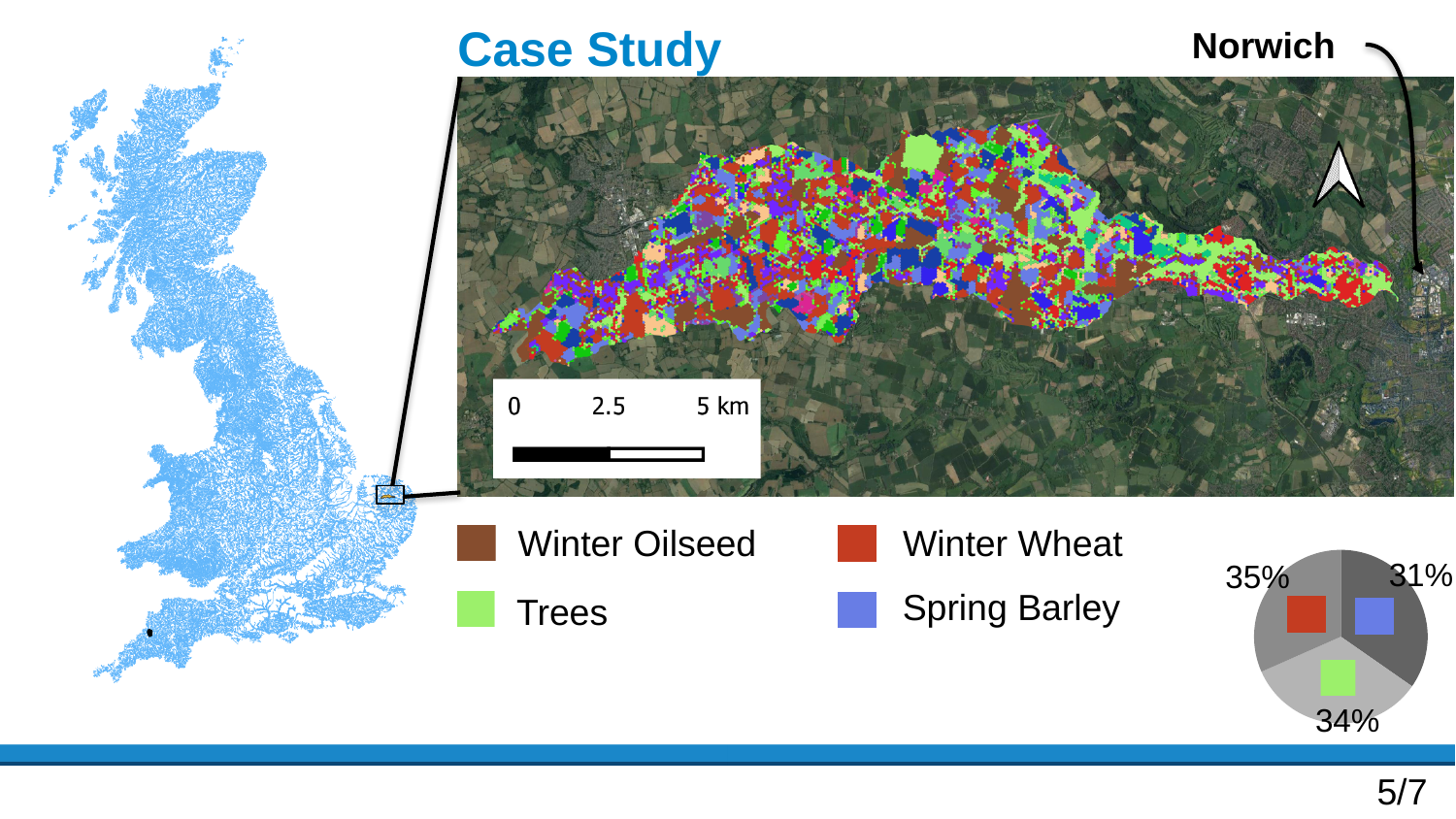
In the pie chart, what percentage is shown for the slice marked with the red square (Winter Wheat)? 35% What do the three percentages in the pie chart add up to? 100% In the pie chart, which is larger: the Trees slice or the Spring Barley slice? Trees Which slice of the pie chart has the smallest share? Spring Barley (31%) In the pie chart, what percentage is shown for the slice marked with the green square (Trees)? 34% How many land-cover classes are listed in the map legend below the case study image? 4 How many slices does the pie chart in the bottom-right corner have? 3 Which legend class from the map is not represented as a slice in the pie chart? Winter Oilseed Which slice of the pie chart has the largest share? Winter Wheat (35%) What kind of chart is shown in the bottom-right corner of the slide? pie chart In the pie chart, what is the difference between the largest slice (35%) and the smallest slice (31%)? 4 percentage points In the pie chart, what percentage is shown for the slice marked with the blue square (Spring Barley)? 31%